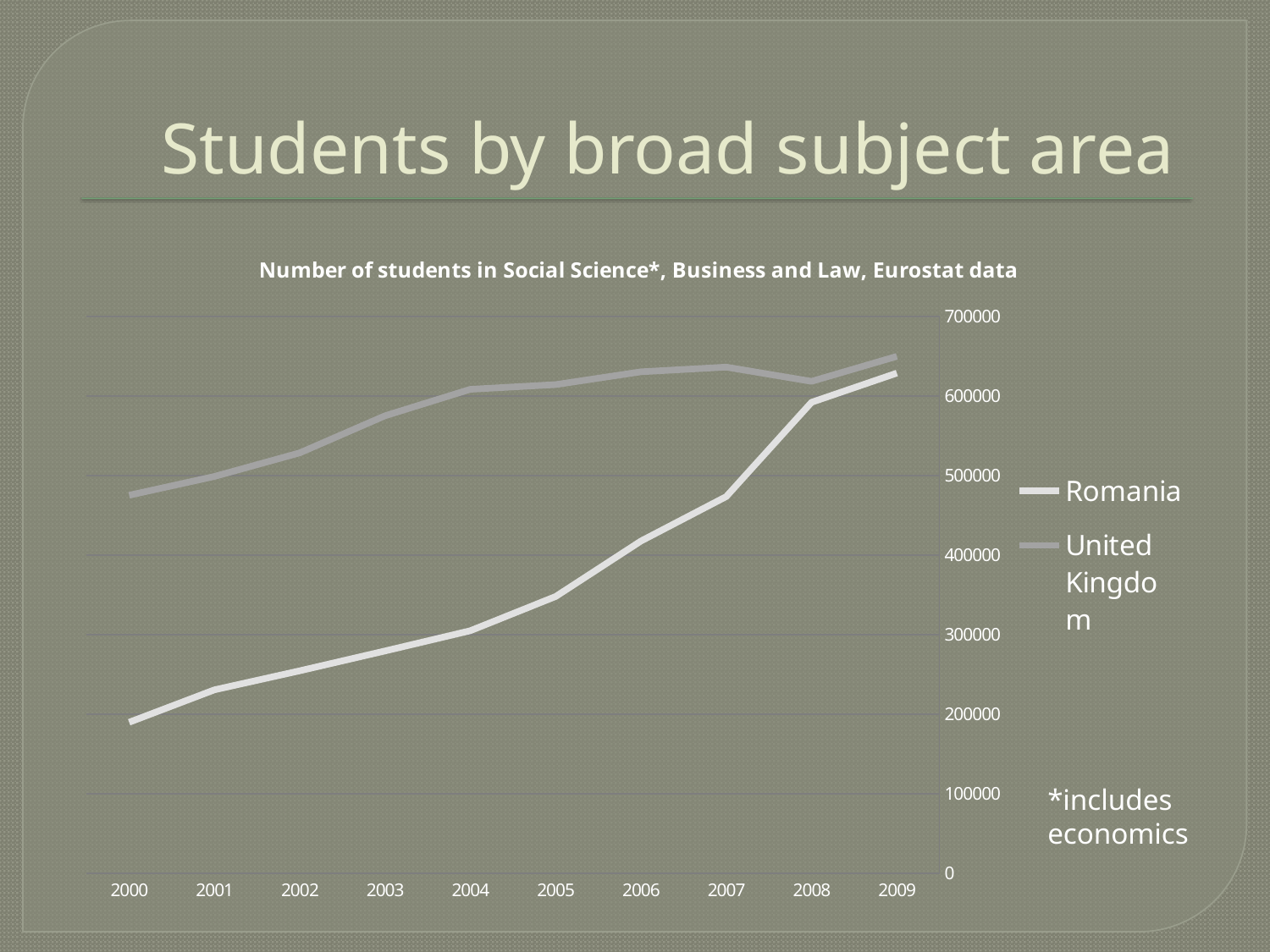
Which series has the larger value in 2000, Romania or United Kingdom? United Kingdom Is the value for United Kingdom in 2000 greater or less than 500000? less Is the value for Romania in 2009 greater or less than 600000? greater Does the number of students for Romania rise or fall from 2000 to 2009? rise In which year is the value for Romania lowest? 2000 How many years are shown on the x axis? 10 What kind of chart is shown on the slide? line chart Is the value for Romania in 2000 greater or less than 200000? less What is the title of the chart? Number of students in Social Science*, Business and Law, Eurostat data In which year is the value for Romania highest? 2009 How many series does the legend list? 2